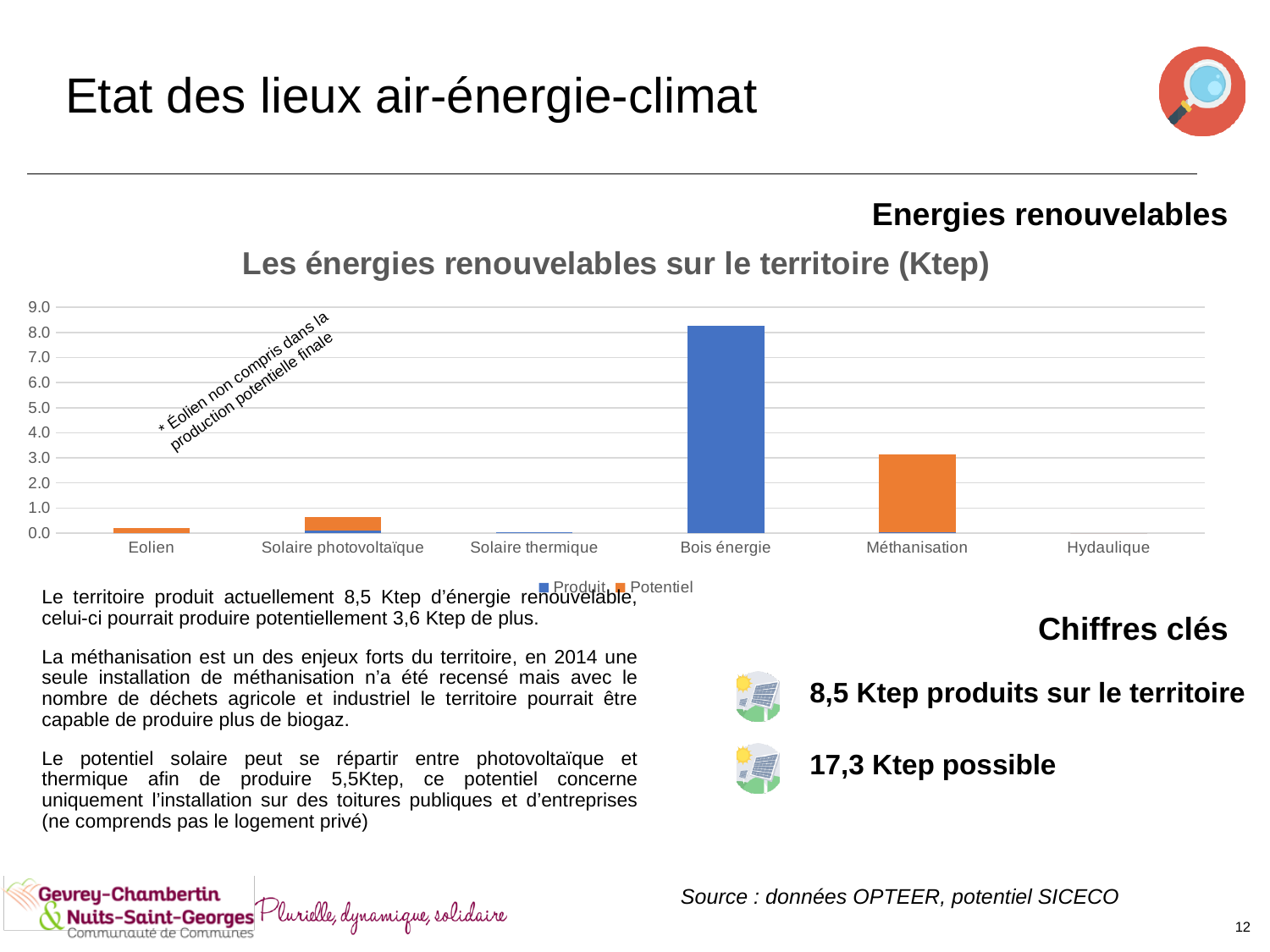
What is the title of the chart? Les énergies renouvelables sur le territoire (Ktep) Which category has the highest Produit value? Bois énergie Which is larger: the Produit value for Bois énergie or the Potentiel value for Méthanisation? Produit value for Bois énergie How many categories are shown on the x axis of the chart? 6 Is the Potentiel value for Solaire photovoltaïque greater or less than 1.0? less Is the Produit value for Bois énergie greater or less than 7.0? greater What kind of chart is shown on the slide? bar chart How many series does the chart legend list? 2 Is the Potentiel value for Méthanisation greater or less than 2.0? greater Which category has the highest Potentiel value? Méthanisation Which is larger: the Potentiel value for Solaire photovoltaïque or the Potentiel value for Eolien? Potentiel value for Solaire photovoltaïque Which colour represents the Potentiel series in the chart? orange